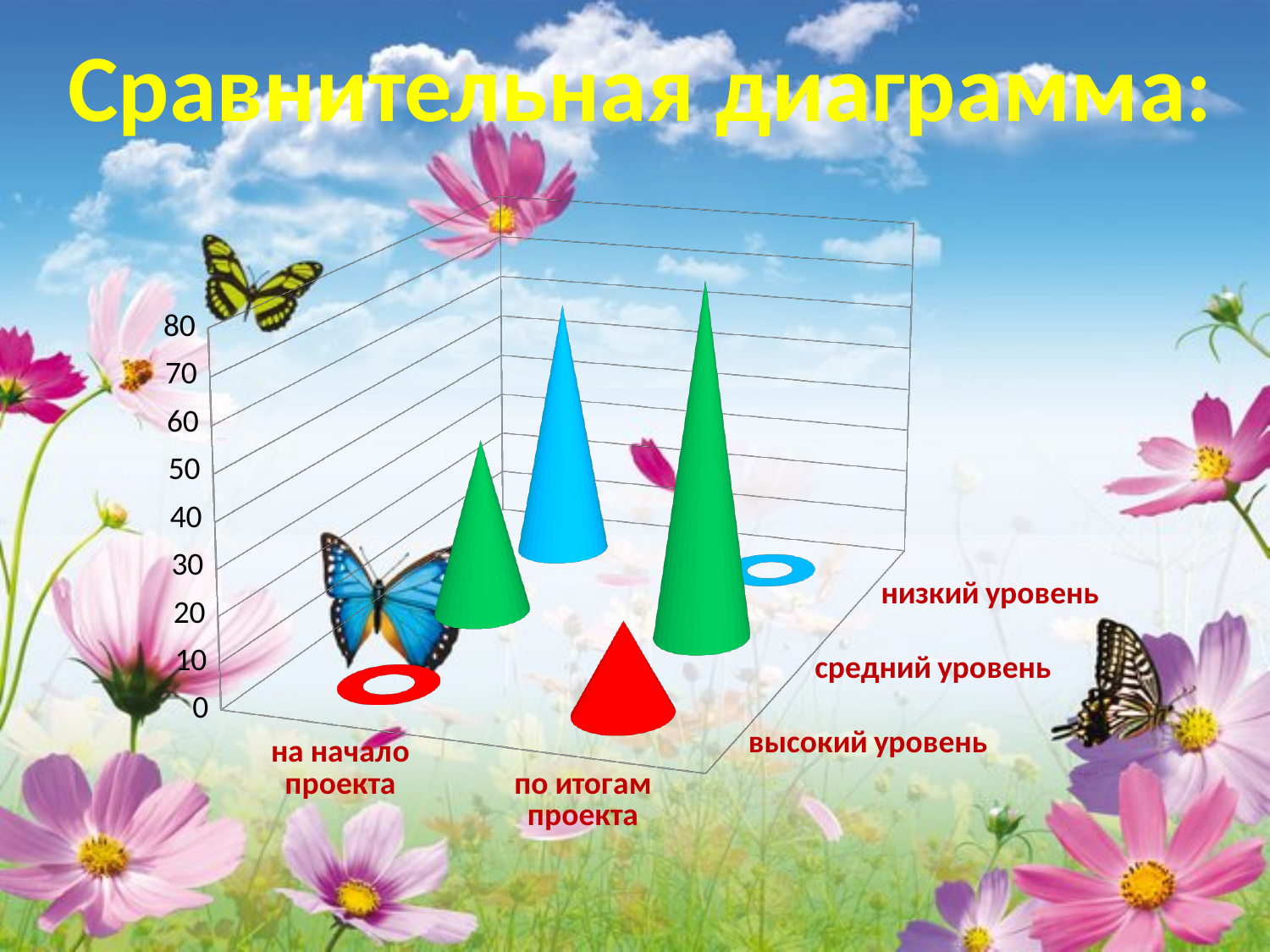
Does the value for высокий уровень rise or fall from на начало проекта to по итогам проекта? rise What colour are the cones for высокий уровень? red What is the title of the chart on the slide? Сравнительная диаграмма: What is the value for высокий уровень at на начало проекта? 0 Is the value for средний уровень at на начало проекта greater or less than 20? greater How many categories are shown along the x axis of the chart? 2 What is the value for низкий уровень at по итогам проекта? 0 Which is larger for средний уровень: the value at на начало проекта or at по итогам проекта? по итогам проекта Which is larger for низкий уровень: the value at на начало проекта or at по итогам проекта? на начало проекта What kind of chart is shown on the slide? bar chart Is the value for низкий уровень at на начало проекта greater or less than 30? greater How many series (levels) does the chart show? 3